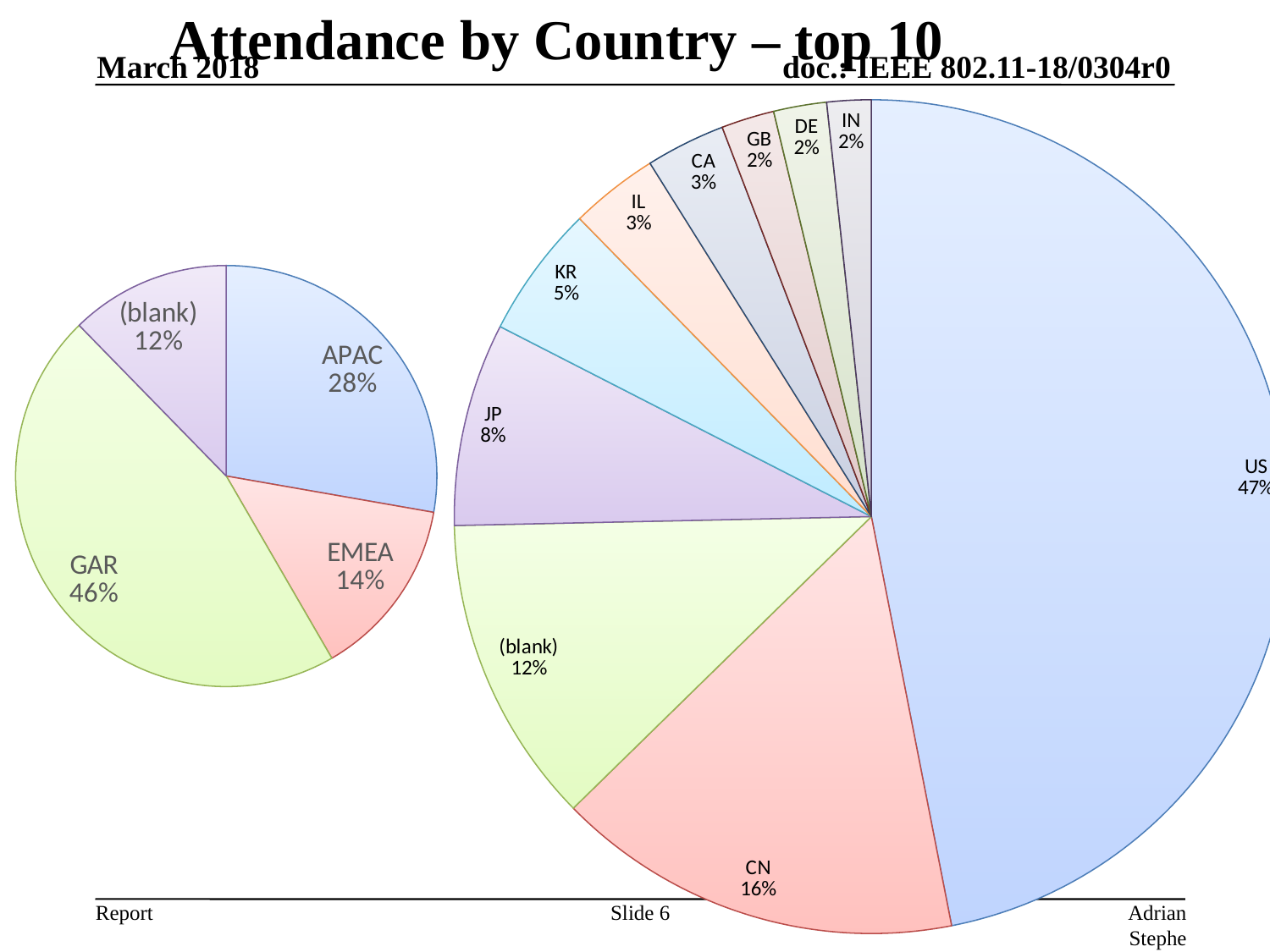
In the left-hand pie chart, what share does EMEA have? 14% In the right-hand pie chart, what is the difference between the US share and the CN share? 31% In the right-hand pie chart, how many slices are there? 10 In the left-hand pie chart, how many slices are there? 4 In the right-hand pie chart, what share does US have? 47% In the right-hand pie chart, which slice is the largest? US In the left-hand pie chart, which slice is the largest? GAR In the left-hand pie chart, what share does GAR have? 46% In the right-hand pie chart, what share does JP have? 8% What kind of chart is the left-hand chart? Pie chart In the left-hand pie chart, which slice is the smallest? (blank) In the right-hand pie chart, what share does CN have? 16%